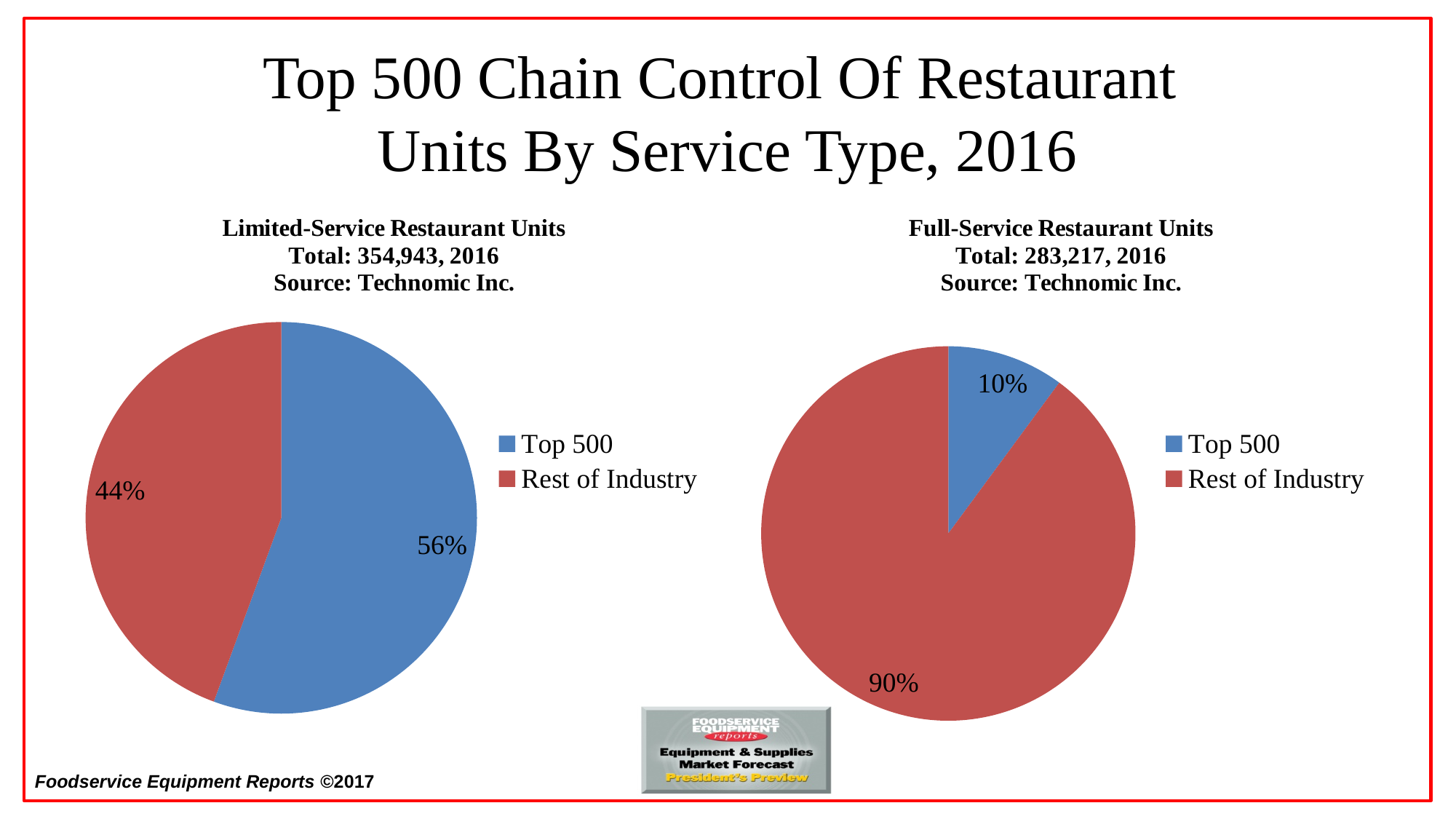
In the Full-Service Restaurant Units chart, what share of units is controlled by the Top 500? 10% In the Limited-Service Restaurant Units chart, what share of units belongs to the Rest of Industry? 44% In the Limited-Service Restaurant Units chart, what is the difference in percentage points between the Top 500 and Rest of Industry slices? 12 percentage points In the Full-Service Restaurant Units chart, what is the difference in percentage points between the Rest of Industry and Top 500 slices? 80 percentage points In the Full-Service Restaurant Units chart, which slice is the smallest? Top 500 What is the total number of Full-Service Restaurant Units stated above the right chart? 283,217 What type of chart is used for the Full-Service Restaurant Units? Pie chart How many slices does the Limited-Service Restaurant Units pie chart have? 2 Is the Top 500 share larger in the Limited-Service Restaurant Units chart or the Full-Service Restaurant Units chart? Limited-Service Restaurant Units In the Limited-Service Restaurant Units chart, which slice is the largest? Top 500 In the Limited-Service Restaurant Units chart, what share of units is controlled by the Top 500? 56% In the Full-Service Restaurant Units chart, what share of units belongs to the Rest of Industry? 90%